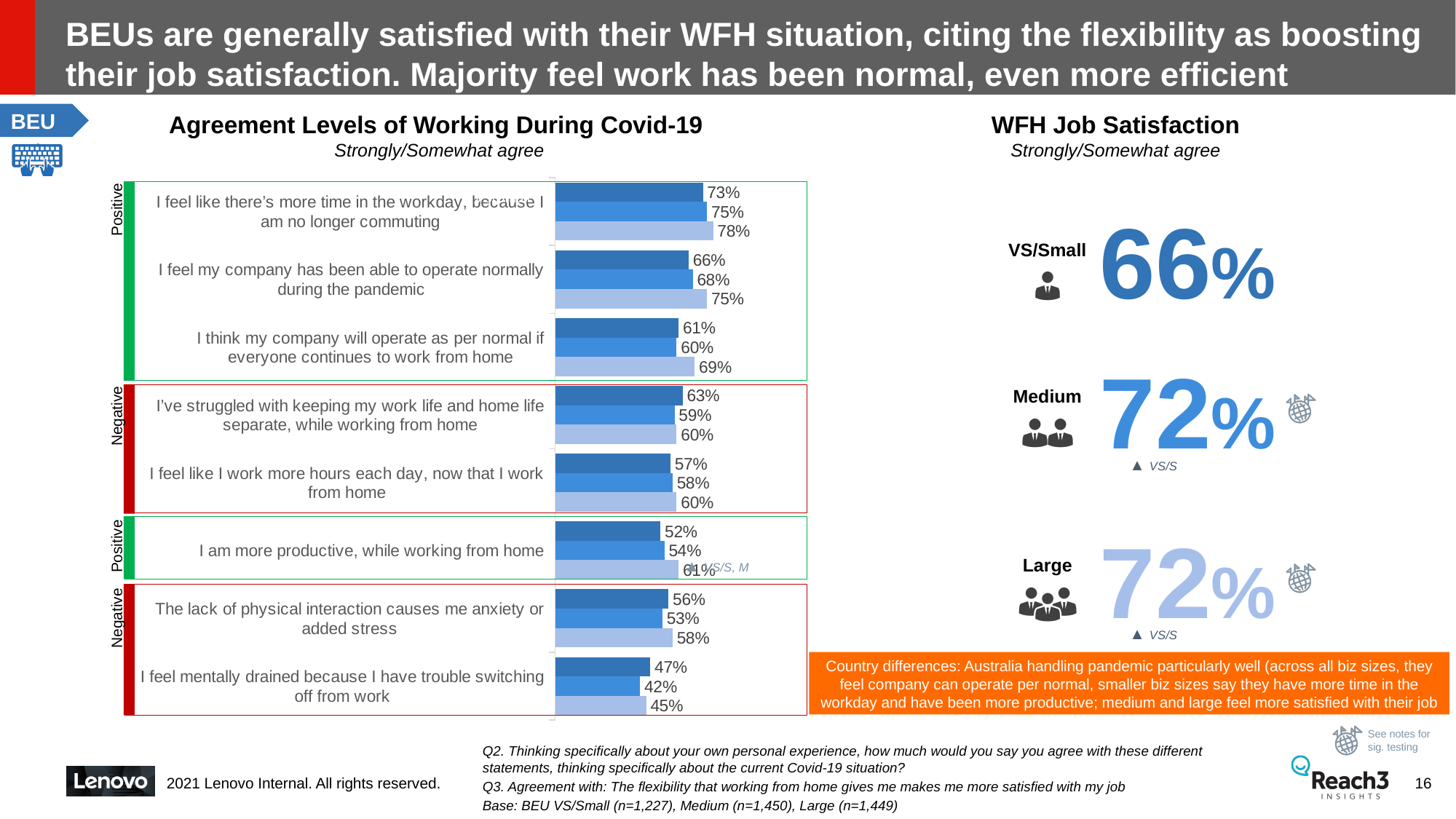
In the 'Agreement Levels of Working During Covid-19' chart, what is the difference between the light blue bar (61%) and the dark blue bar (52%) for 'I am more productive, while working from home'? 9 percentage points In the 'Agreement Levels of Working During Covid-19' chart, which has the larger dark blue bar value: 'I've struggled with keeping my work life and home life separate' or 'I feel like I work more hours each day'? I've struggled with keeping my work life and home life separate In the 'Agreement Levels of Working During Covid-19' chart, what is the value of the top (dark blue) bar for 'I feel like there's more time in the workday, because I am no longer commuting'? 73% In the 'Agreement Levels of Working During Covid-19' chart, which statement has the highest light blue bar value? I feel like there's more time in the workday, because I am no longer commuting How many statements are listed in the 'Agreement Levels of Working During Covid-19' chart? 8 What is the subtitle shown under the 'Agreement Levels of Working During Covid-19' chart title? Strongly/Somewhat agree In the 'Agreement Levels of Working During Covid-19' chart, which statement has the lowest value of any bar? I feel mentally drained because I have trouble switching off from work In the 'Agreement Levels of Working During Covid-19' chart, what is the value of the middle (medium blue) bar for 'I feel mentally drained because I have trouble switching off from work'? 42% In the 'Agreement Levels of Working During Covid-19' chart, how many bars are shown for each statement? 3 What type of chart is 'Agreement Levels of Working During Covid-19'? bar chart In the 'Agreement Levels of Working During Covid-19' chart, what is the value of the bottom (light blue) bar for 'I feel my company has been able to operate normally during the pandemic'? 75% In the 'Agreement Levels of Working During Covid-19' chart, what is the difference between the light blue bar (78%) and the dark blue bar (73%) for 'I feel like there's more time in the workday, because I am no longer commuting'? 5 percentage points